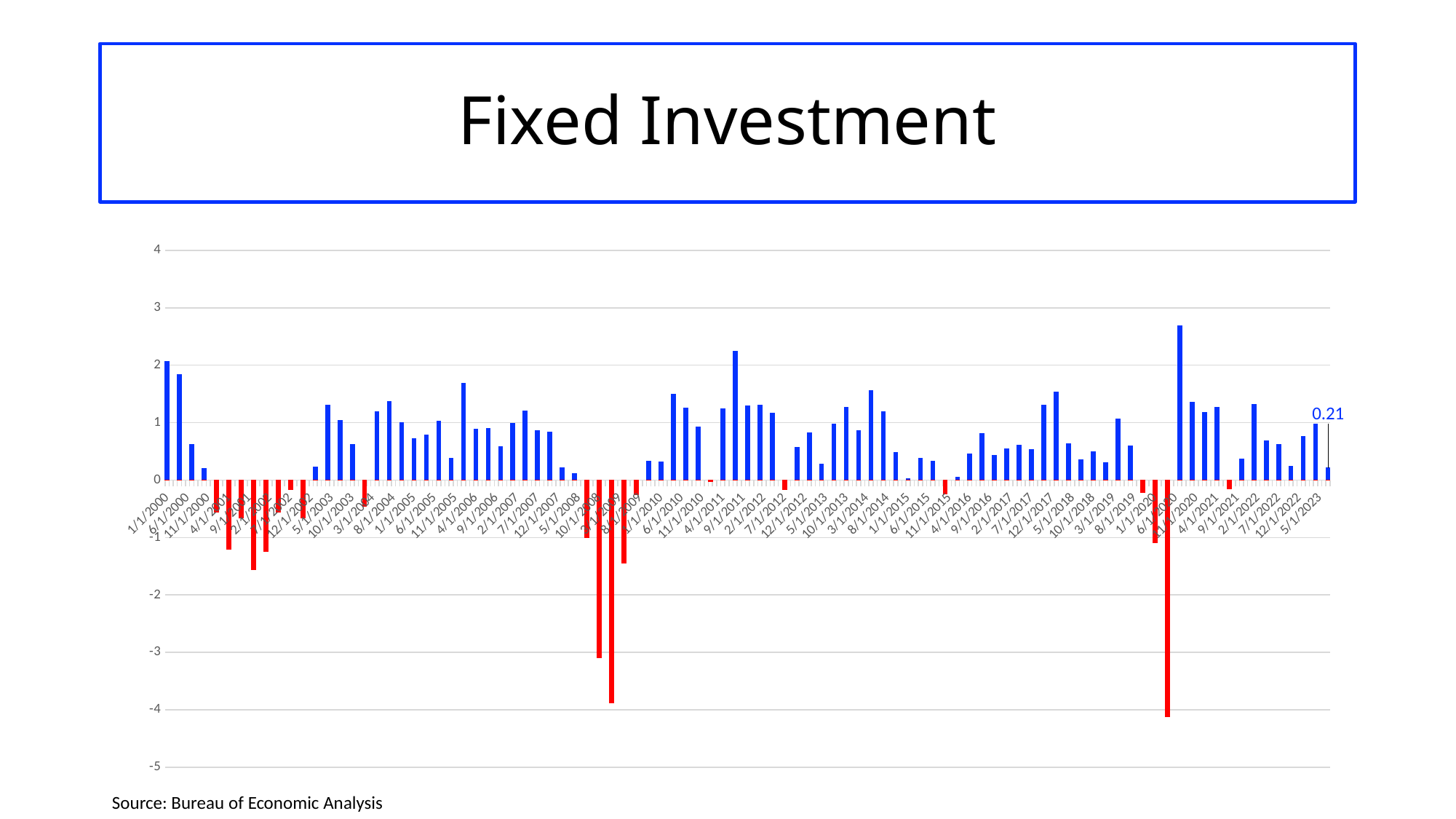
What is the title of the chart? Fixed Investment Is the value of the rightmost bar (labelled 0.21) greater or less than 1? less What value is printed on the data label of the rightmost bar? 0.21 Is the highest value plotted on the chart greater or less than 2? greater What colour are the bars with negative values? red Is the highest value plotted on the chart greater or less than 3? less What type of chart is shown on the slide? bar chart Which is larger, the first bar on the left (1/1/2000) or the rightmost bar labelled 0.21? the first bar (1/1/2000)